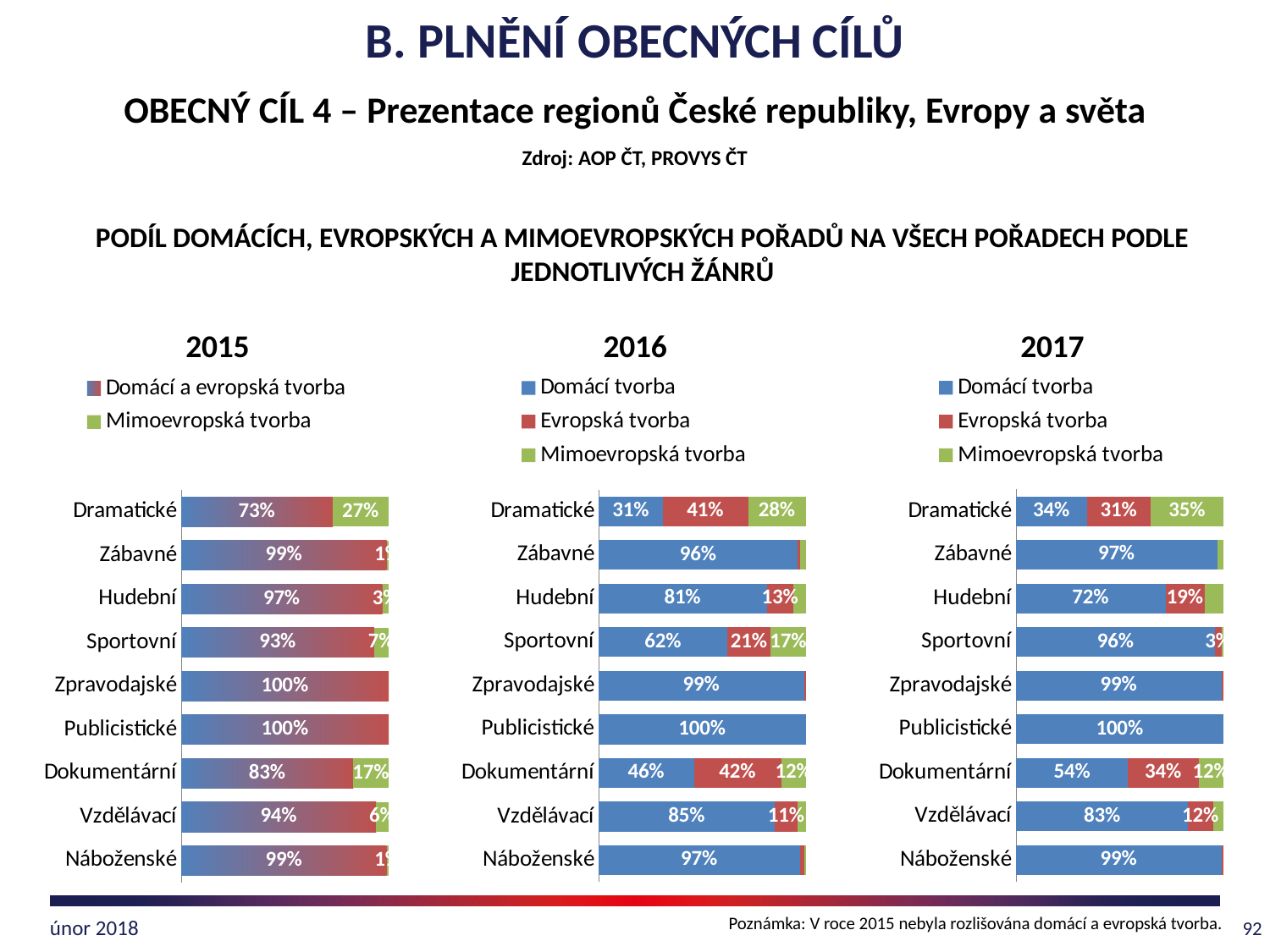
How many series does the legend of the 2017 chart list? 3 In the 2015 chart, what is the value of Domácí a evropská tvorba for Dramatické? 73% What type of chart is the 2015 chart? Stacked bar chart In the 2015 chart, which genre has the highest value of Mimoevropská tvorba? Dramatické In the 2016 chart, what is the value of Evropská tvorba for Dokumentární? 42% How many series does the legend of the 2015 chart list? 2 How many genres are shown in the 2016 chart? 9 In the 2017 chart, what is the value of Domácí tvorba for Hudební? 72% In the 2017 chart, which is larger: Domácí tvorba for Dokumentární or Domácí tvorba for Dramatické? Dokumentární In the 2017 chart, what is the value of Mimoevropská tvorba for Dramatické? 35% In the 2016 chart, what is the difference between Domácí tvorba for Sportovní and Domácí tvorba for Dramatické? 31% In the 2016 chart, which genre has the lowest value of Domácí tvorba? Dramatické